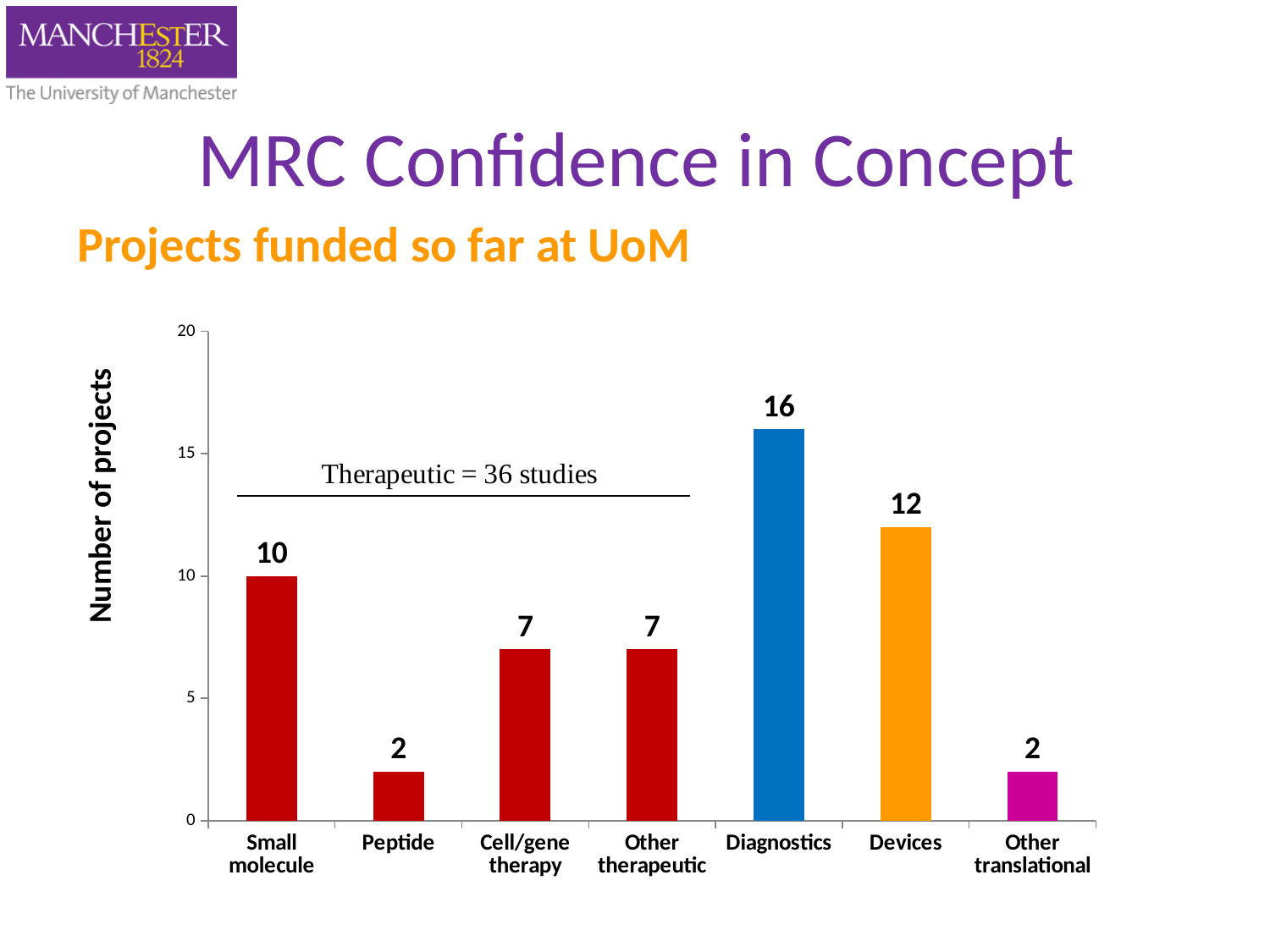
Which category has the highest number of projects? Diagnostics What kind of chart is shown on the slide? Bar chart Which has more projects, Small molecule or Cell/gene therapy? Small molecule According to the annotation on the chart, how many studies are therapeutic in total? 36 studies What is the number of projects for Diagnostics? 16 What is the number of projects for Small molecule? 10 What is the number of projects for Peptide? 2 What is the difference in number of projects between Diagnostics and Devices? 4 What is the number of projects for Devices? 12 Is the value for Devices greater or less than 10? greater What is the label of the y axis? Number of projects How many categories are shown on the x axis? 7